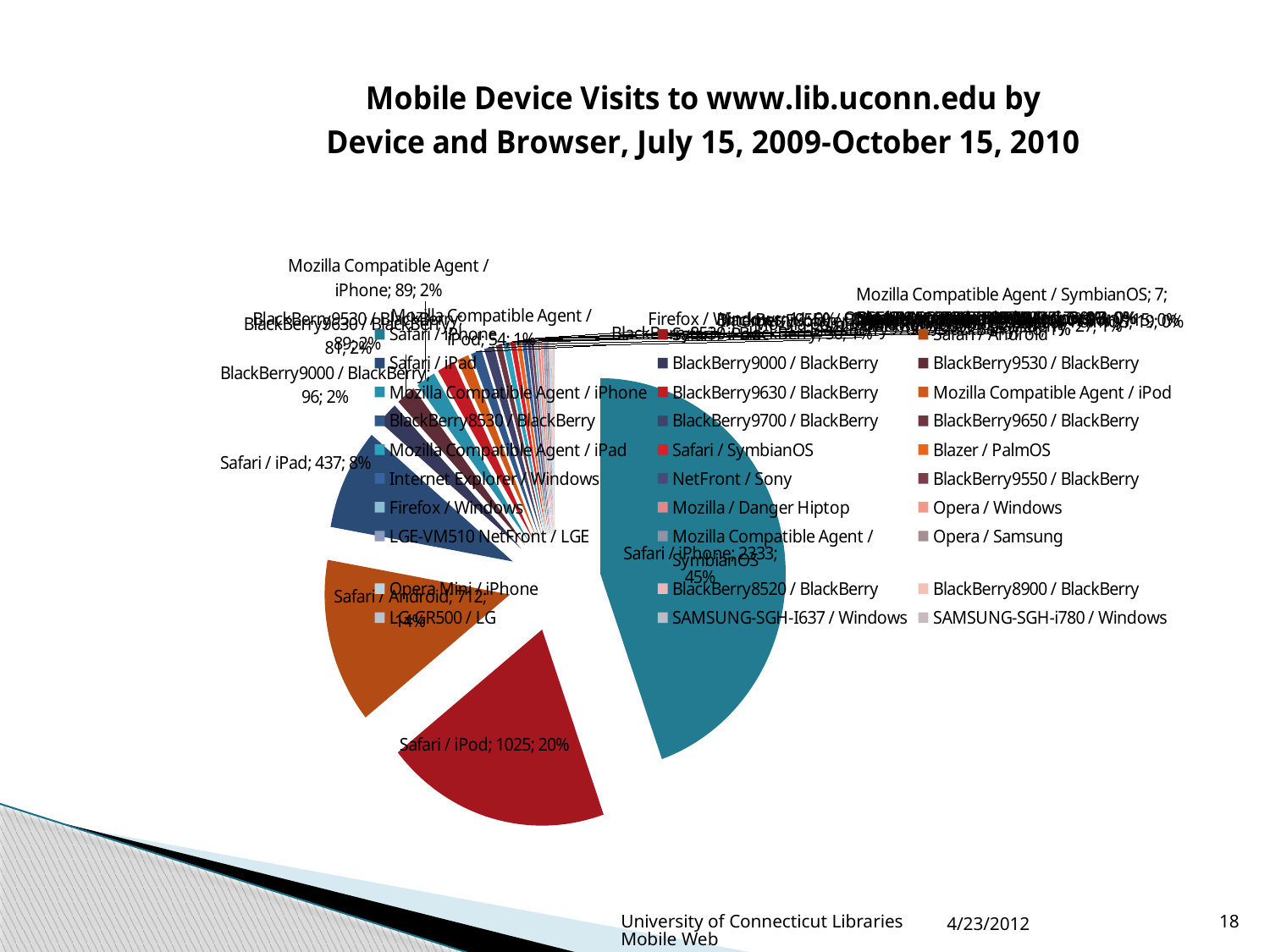
How many visits are shown for Safari / iPod? 1025 What date range does the chart title cover? July 15, 2009-October 15, 2010 What kind of chart is shown on the slide? pie chart How many visits are shown for Safari / iPhone? 2333 How many visits are shown for Safari / Android? 712 How many visits are shown for BlackBerry9000 / BlackBerry? 96 What percentage of visits does Safari / iPod account for? 20% How many visits are shown for Safari / iPad? 437 What percentage of visits does Safari / iPhone account for? 45% What is the difference in visits between Safari / iPhone and Safari / iPod? 1308 Which has more visits, Safari / Android or Safari / iPad? Safari / Android Which device and browser combination has the largest share of mobile device visits? Safari / iPhone